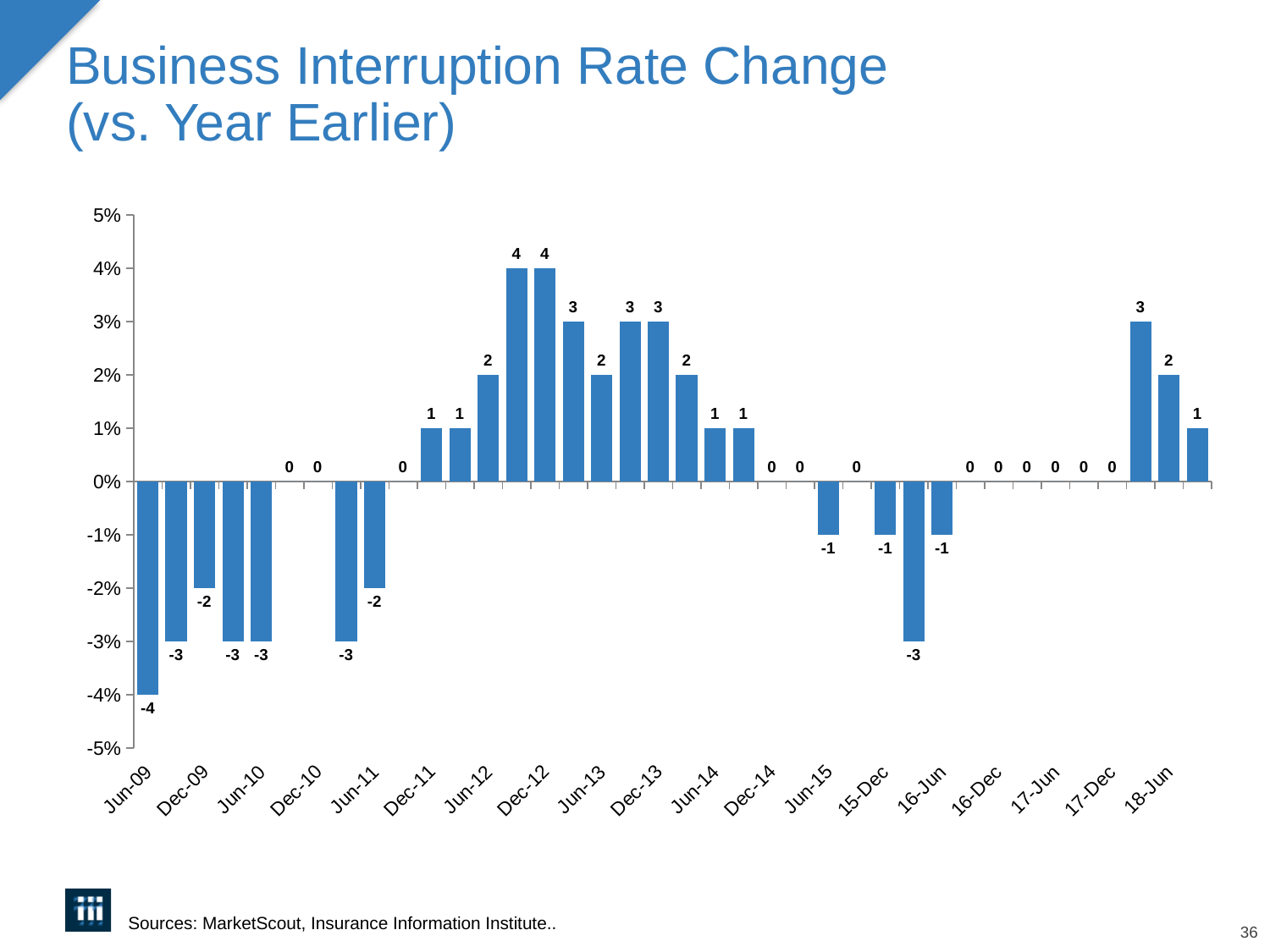
Which is larger, the value for Dec-12 or the value for Dec-13? Dec-12 Which period has the lowest business interruption rate change? Jun-09 Do the values rise or fall from Jun-09 to Dec-12? rise What is the business interruption rate change for Jun-09? -4 What kind of chart is shown on the slide? bar chart What is the title of the chart on the slide? Business Interruption Rate Change (vs. Year Earlier) What is the business interruption rate change for 17-Dec? 0 What is the business interruption rate change for Dec-12? 4 What is the difference between the value for Dec-12 and the value for Jun-09? 8 What is the business interruption rate change for Dec-13? 3 Is the value for Jun-09 greater or less than -3%? less What is the highest value plotted on the chart? 4